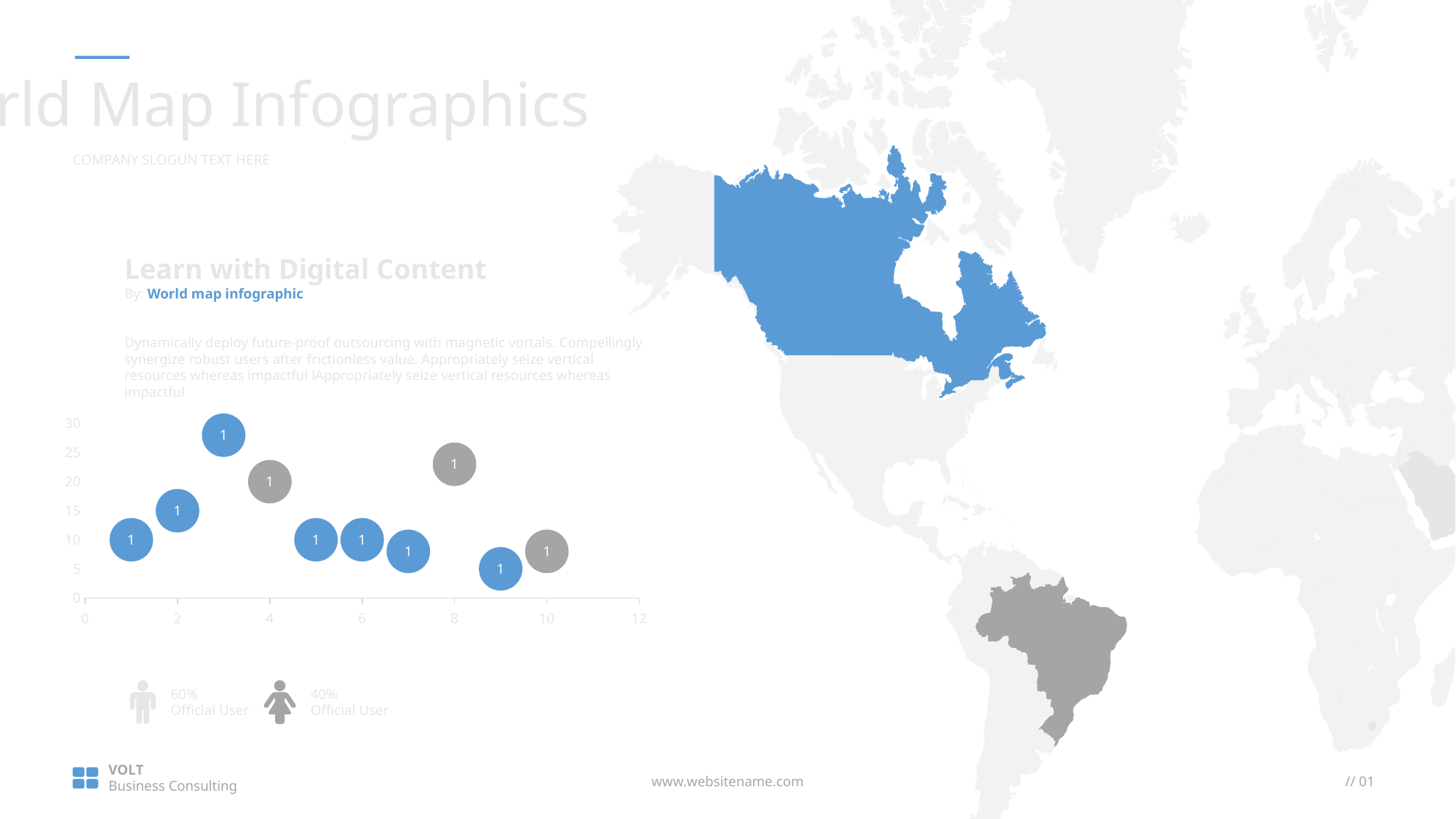
How many blue bubbles are plotted in the chart? 7 How many gray bubbles are plotted in the chart? 3 At which x-axis position is the lowest bubble in the chart? 9 How many bubbles are plotted in the chart? 10 Is the bubble at x = 9 greater or less than 10 on the y axis? less What is the maximum value shown on the chart's y axis? 30 At which x-axis position is the highest bubble in the chart? 3 Is the bubble at x = 3 greater or less than 25 on the y axis? greater What data label is printed on each bubble in the chart? 1 What kind of chart is shown on the left of the slide? bubble chart Is the bubble at x = 8 greater or less than 20 on the y axis? greater